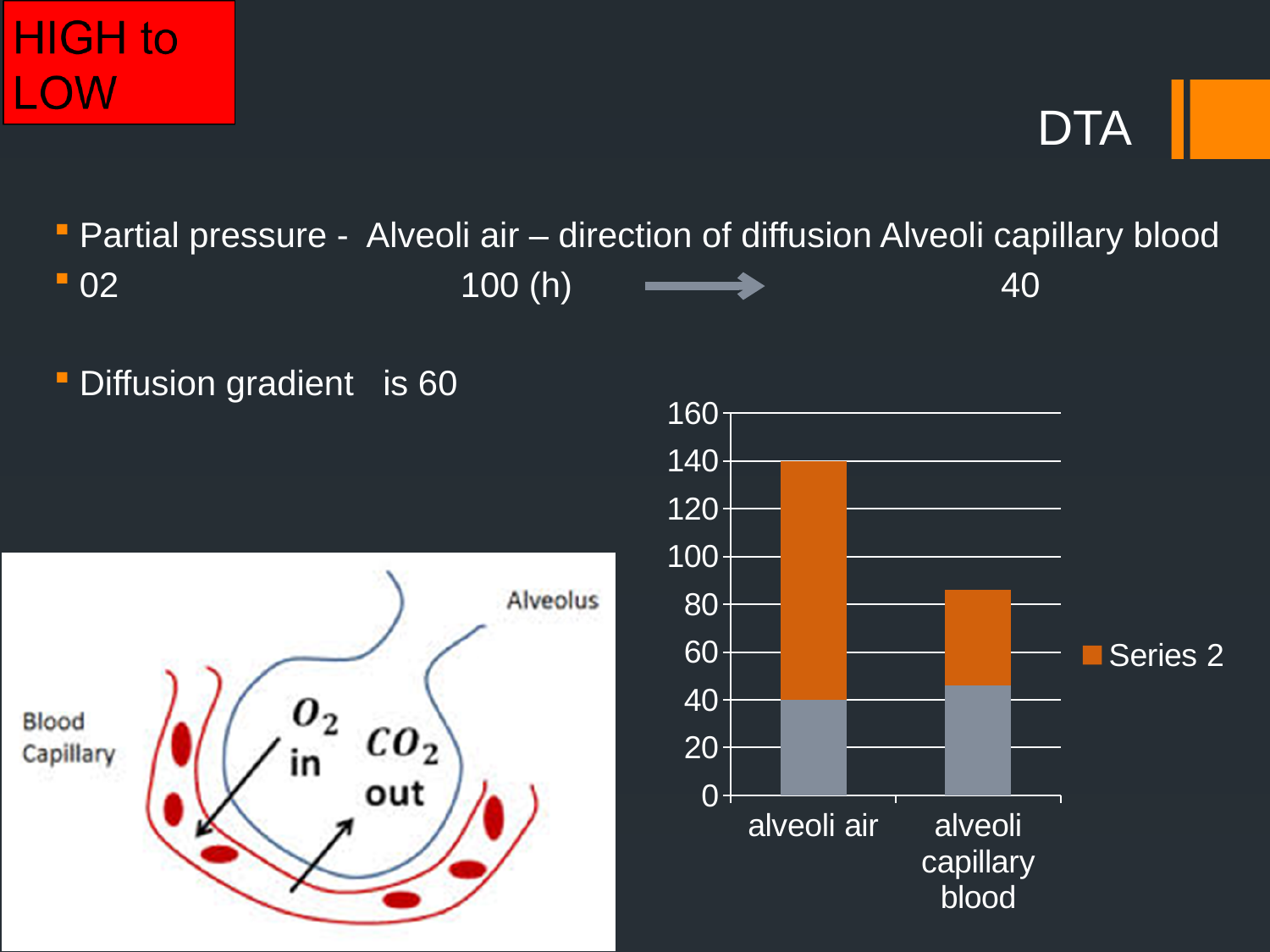
Is the total height of the bar for alveoli capillary blood greater or less than 80? greater Which category has the taller stacked bar, alveoli air or alveoli capillary blood? alveoli air Do the total bar heights rise or fall from alveoli air to alveoli capillary blood? fall Which category has the lowest total bar height? alveoli capillary blood What is the total height of the stacked bar for alveoli air? 140 What kind of chart is shown on the slide? stacked bar chart How many categories are shown on the x axis of the chart? 2 What series name appears in the chart legend? Series 2 What is the highest value shown on the chart's vertical axis? 160 How many series does the chart legend list? 1 Is the grey segment of the alveoli capillary blood bar greater or less than 60? less Is the total height of the bar for alveoli capillary blood greater or less than 100? less